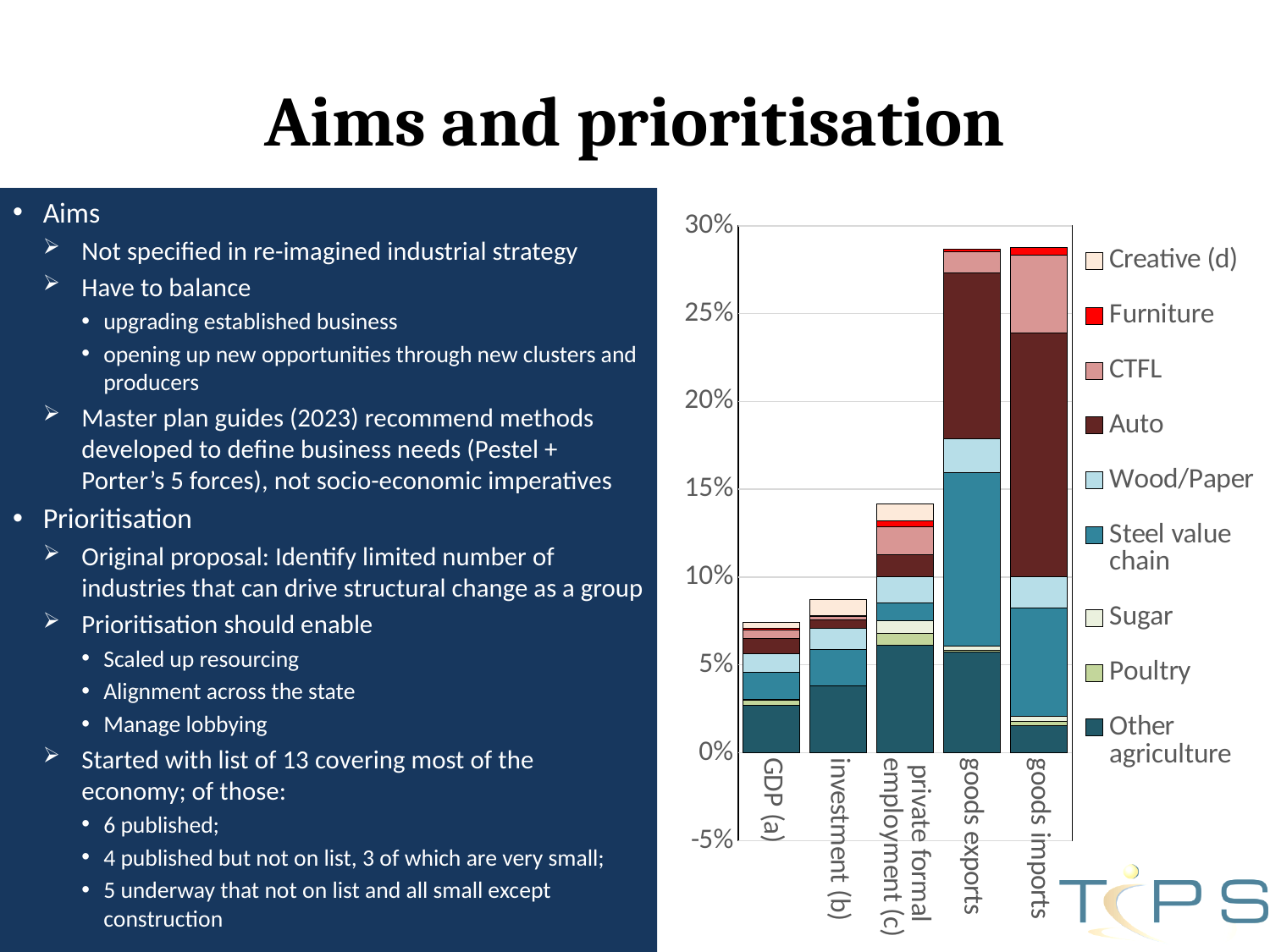
Which has the larger total stacked value, private formal employment (c) or GDP (a)? private formal employment (c) Is the total stacked value for goods exports greater or less than 25%? greater Which has the larger total stacked value, goods imports or investment (b)? goods imports Is the total stacked value for investment (b) greater or less than 10%? less How many series does the chart's legend list? 9 What kind of chart is shown on the slide? Stacked bar chart Which series is shown in bright red in the legend? Furniture Is the total stacked value for GDP (a) greater or less than 10%? less How many categories are shown along the x axis of the chart? 5 What is the lowest value shown on the chart's y axis? -5% Which category has the lowest total stacked value? GDP (a)